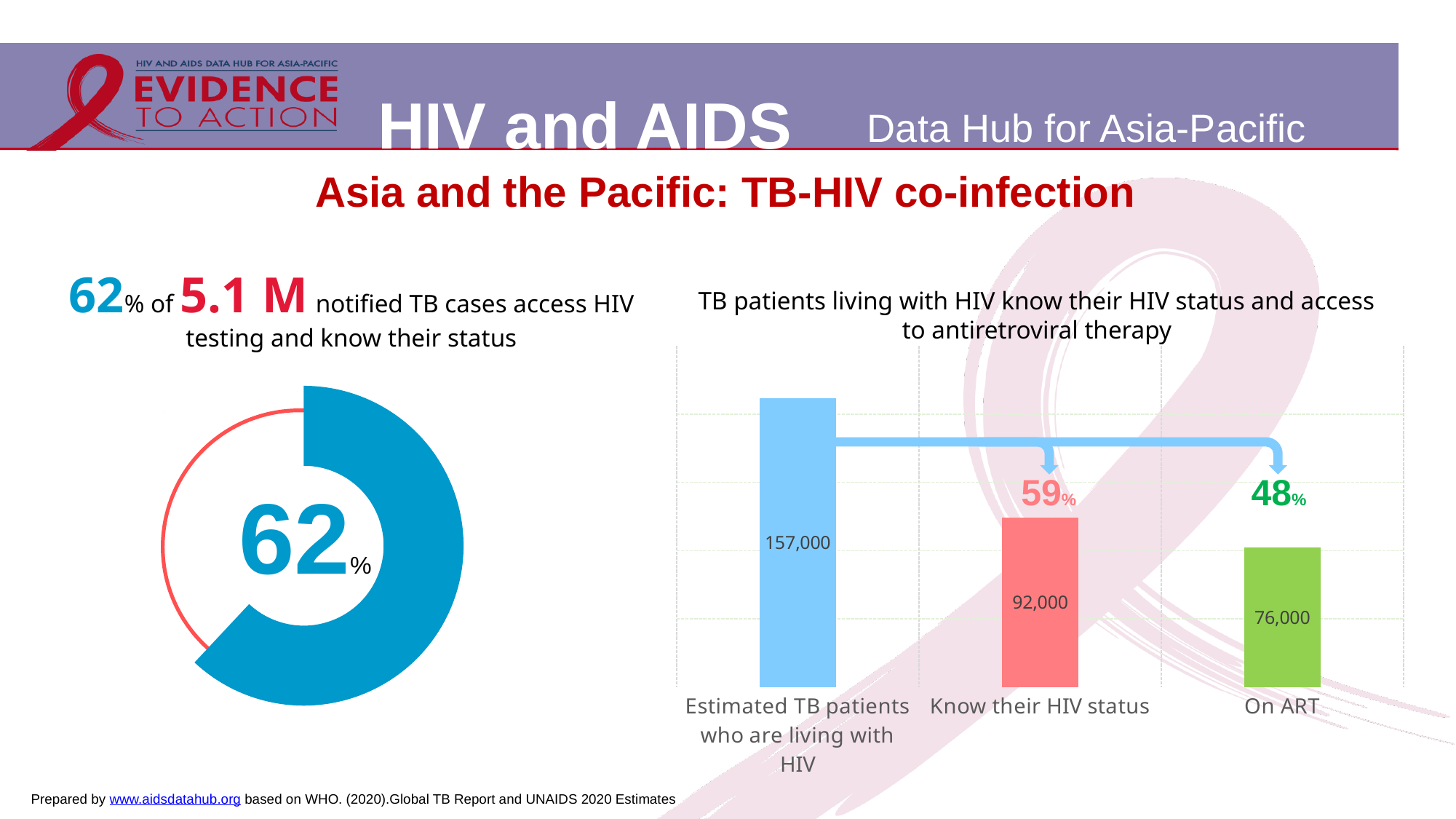
In the bar chart on the right, which category has the highest value? Estimated TB patients who are living with HIV In the bar chart on the right, which category has the lowest value? On ART In the bar chart on the right, what is the difference between the value for Know their HIV status and the value for On ART? 16,000 What kind of chart is the chart on the right of the slide? Bar chart What percentage is shown in the centre of the donut chart on the left of the slide? 62% How many categories are shown in the bar chart on the right? 3 In the bar chart on the right, what is the difference between the value for Estimated TB patients who are living with HIV and the value for Know their HIV status? 65,000 In the bar chart on the right, what is the value for Estimated TB patients who are living with HIV? 157,000 In the bar chart on the right, do the values rise or fall from left to right across the categories? Fall In the bar chart on the right, which is larger: the value for Know their HIV status or the value for On ART? Know their HIV status In the bar chart on the right, what is the value for On ART? 76,000 In the bar chart on the right, what is the value for Know their HIV status? 92,000